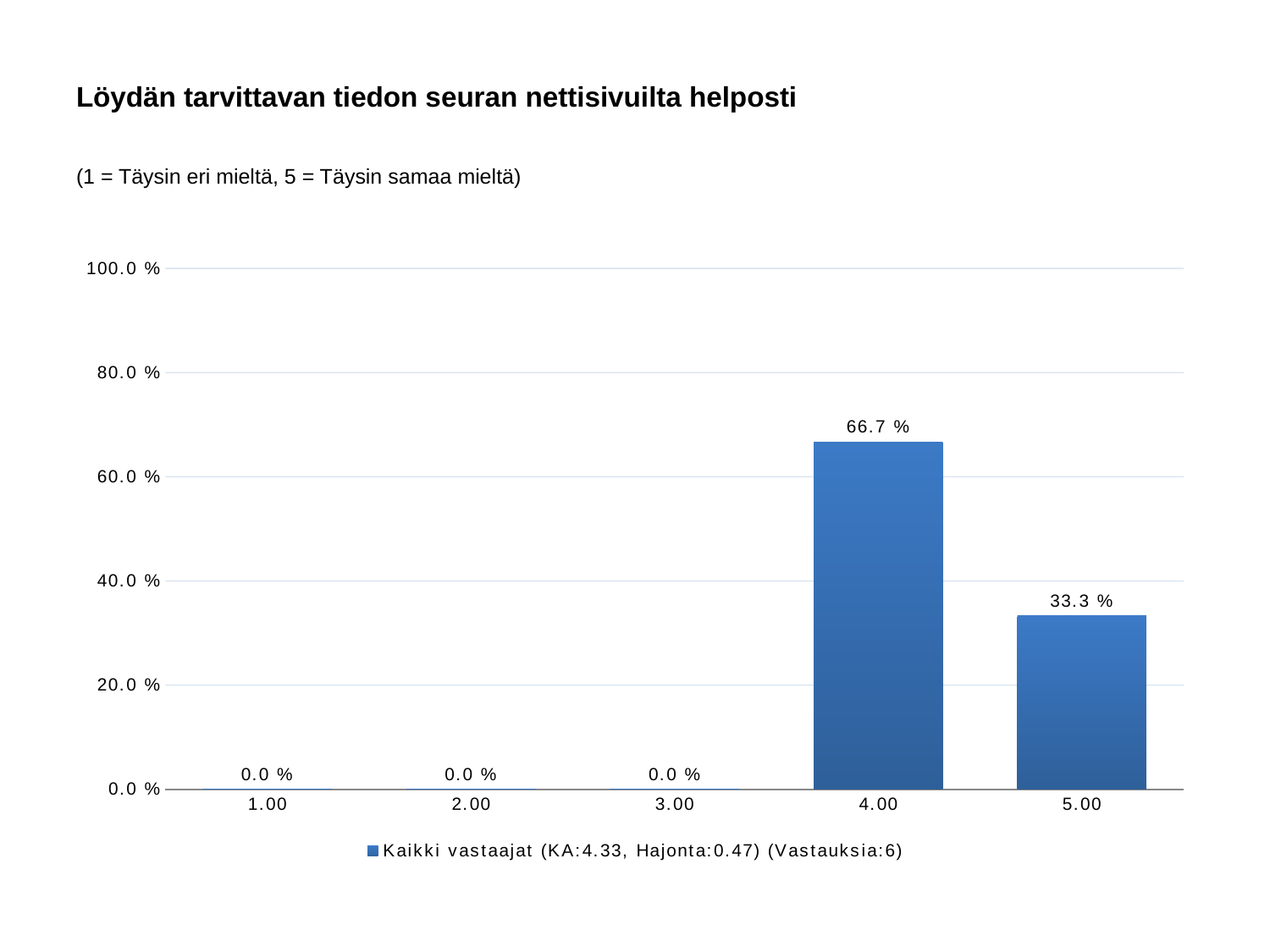
Which category has the highest value? 4.00 What is the value for category 1.00? 0.0 % What is the value for category 4.00? 66.7 % How many categories are shown on the x axis? 5 Which is larger, the value for 4.00 or the value for 5.00? 4.00 What is the value for category 5.00? 33.3 % What is the difference between the values for 4.00 and 5.00? 33.4 % Is the value for 4.00 greater or less than 60.0 %? greater What kind of chart is shown? bar chart How many series does the legend list? 1 Is the value for 5.00 greater or less than 40.0 %? less What is the legend entry for the series? Kaikki vastaajat (KA:4.33, Hajonta:0.47) (Vastauksia:6)